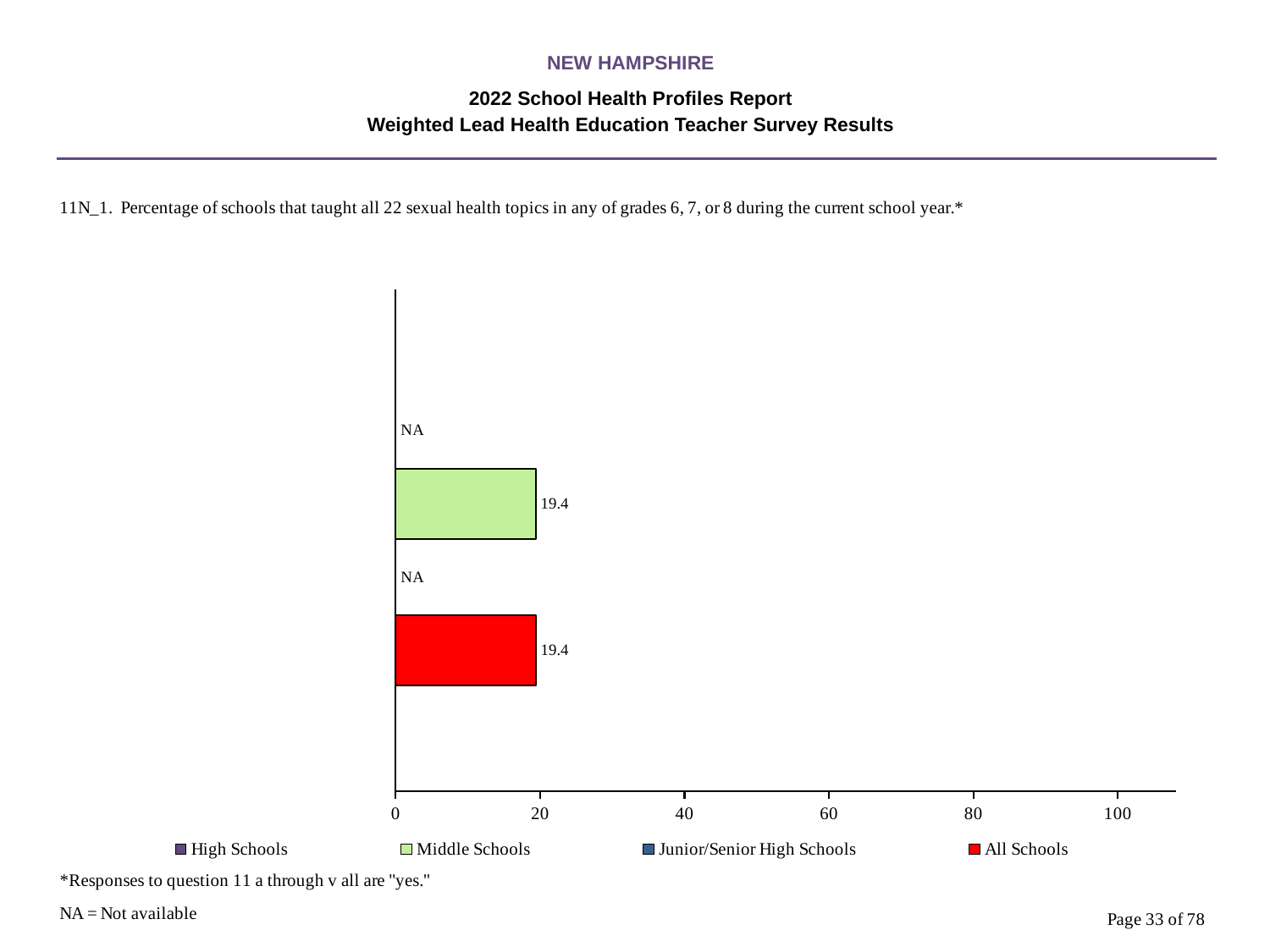
What kind of chart is shown on the slide? Bar chart Is the value for Middle Schools greater or less than 20? less What is the highest value shown on the x axis? 100 What is shown for High Schools? NA How many series have a plotted bar with a numeric value? 2 What colour is the All Schools bar? Red What is shown for Junior/Senior High Schools? NA Is the value for All Schools greater or less than 40? less What is the value for All Schools? 19.4 How many series does the legend list? 4 What is the difference between the Middle Schools value and the All Schools value? 0 What is the value for Middle Schools? 19.4